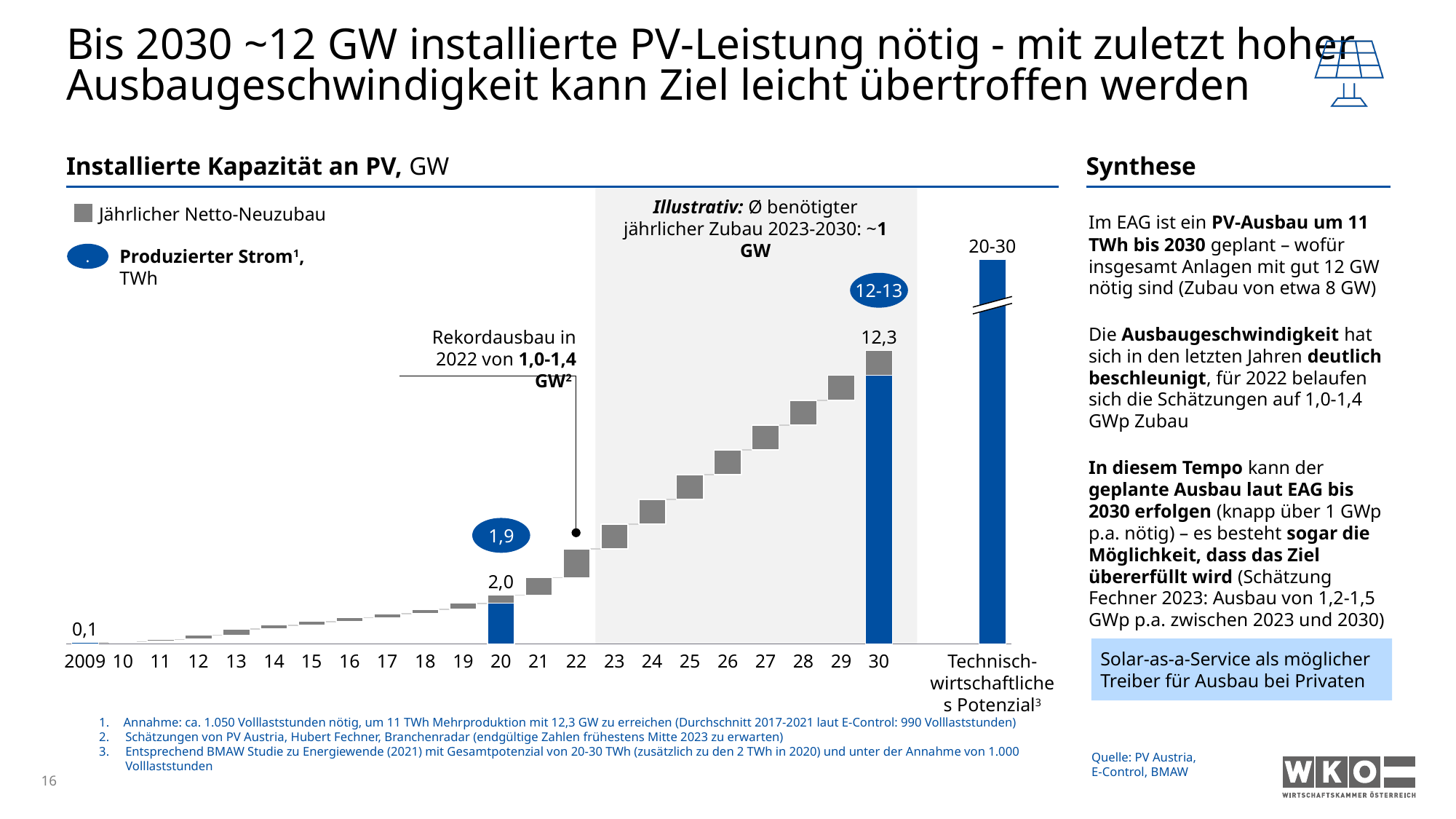
What value of produced electricity (TWh) is shown in the blue oval for 2030? 12-13 Do the installed capacity values rise or fall from 2009 to 2030 along the x axis? rise What is the title of the chart? Installierte Kapazität an PV, GW According to the annotation in the shaded area, what average annual addition is needed for 2023-2030? ~1 GW What installed PV capacity in GW is shown for 2030 in the chart? 12,3 What value is shown above the bar for 'Technisch-wirtschaftliches Potenzial'? 20-30 Which year has the higher installed capacity, 2020 or 2030? 2030 What is the installed PV capacity shown for 2009 in the chart? 0,1 How many entries does the chart legend list? 2 What value of produced electricity (TWh) is shown in the blue oval for 2020? 1,9 What is the difference between the installed capacity for 2030 and for 2020 in GW? 10,3 What is the installed PV capacity shown for 2020 in the chart? 2,0